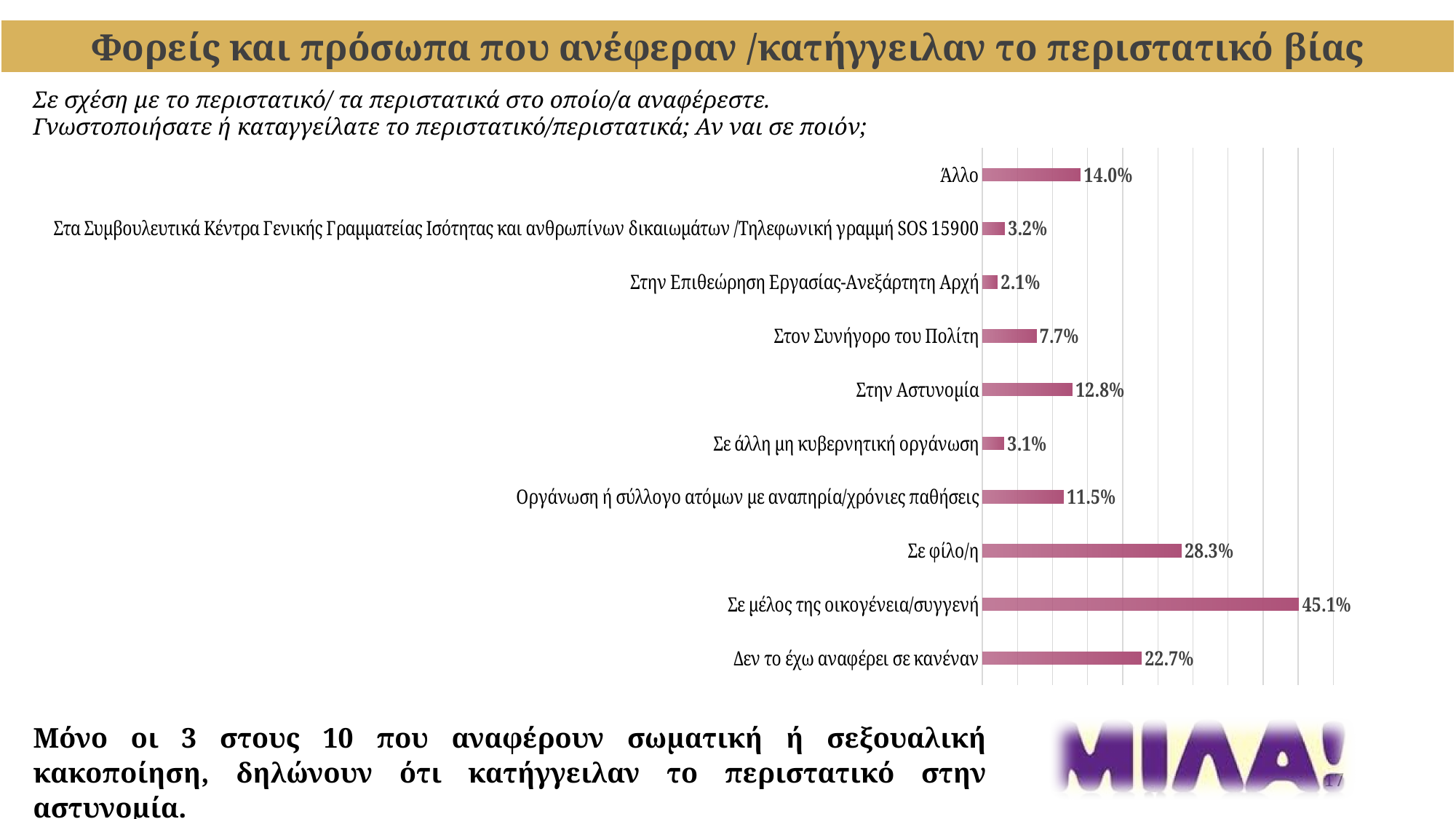
What is the value for "Σε φίλο/η"? 28.3% Which category has the lowest value? Στην Επιθεώρηση Εργασίας-Ανεξάρτητη Αρχή How many categories are shown in the chart? 10 Which is larger, the value for "Οργάνωση ή σύλλογο ατόμων με αναπηρία/χρόνιες παθήσεις" or the value for "Στον Συνήγορο του Πολίτη"? Οργάνωση ή σύλλογο ατόμων με αναπηρία/χρόνιες παθήσεις What kind of chart is shown on the slide? Bar chart Which category has the highest value? Σε μέλος της οικογένεια/συγγενή What is the value for "Δεν το έχω αναφέρει σε κανέναν"? 22.7% What is the value for "Στον Συνήγορο του Πολίτη"? 7.7% What is the value for "Στην Αστυνομία"? 12.8% What is the difference between the values for "Άλλο" and "Στην Αστυνομία"? 1.2% What is the difference between the values for "Σε μέλος της οικογένεια/συγγενή" and "Σε φίλο/η"? 16.8% Which is larger, the value for "Δεν το έχω αναφέρει σε κανέναν" or the value for "Άλλο"? Δεν το έχω αναφέρει σε κανέναν